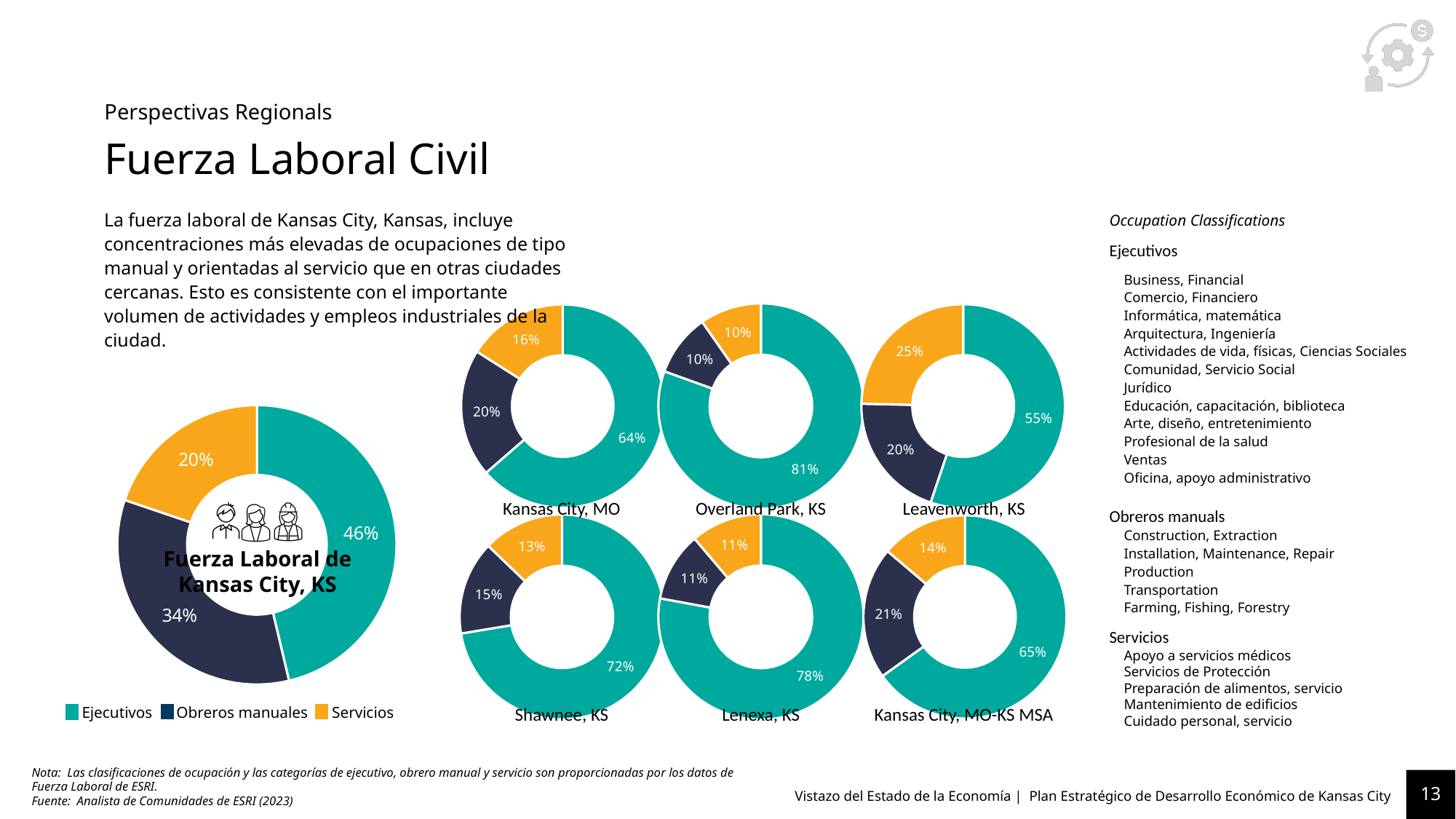
In the Fuerza Laboral de Kansas City, KS chart, which category has the smallest share? Servicios Which is larger: the Ejecutivos share in Lenexa, KS or the Ejecutivos share in Kansas City, MO? Lenexa, KS How many donut charts are shown on the slide in total? 7 In the Kansas City, MO-KS MSA chart, what share is Obreros manuales? 21% In the Overland Park, KS chart, what share is Ejecutivos? 81% In the Fuerza Laboral de Kansas City, KS chart, what share is Obreros manuales? 34% In the Shawnee, KS chart, what is the difference between the Ejecutivos share and the Obreros manuales share? 57% In the Leavenworth, KS chart, what share is Servicios? 25% In the Fuerza Laboral de Kansas City, KS chart, what share is Ejecutivos? 46% Which colour represents Servicios in the donut charts? Orange What type of chart is used to show the Fuerza Laboral de Kansas City, KS data? Donut chart How many categories does the legend list for the donut charts? 3